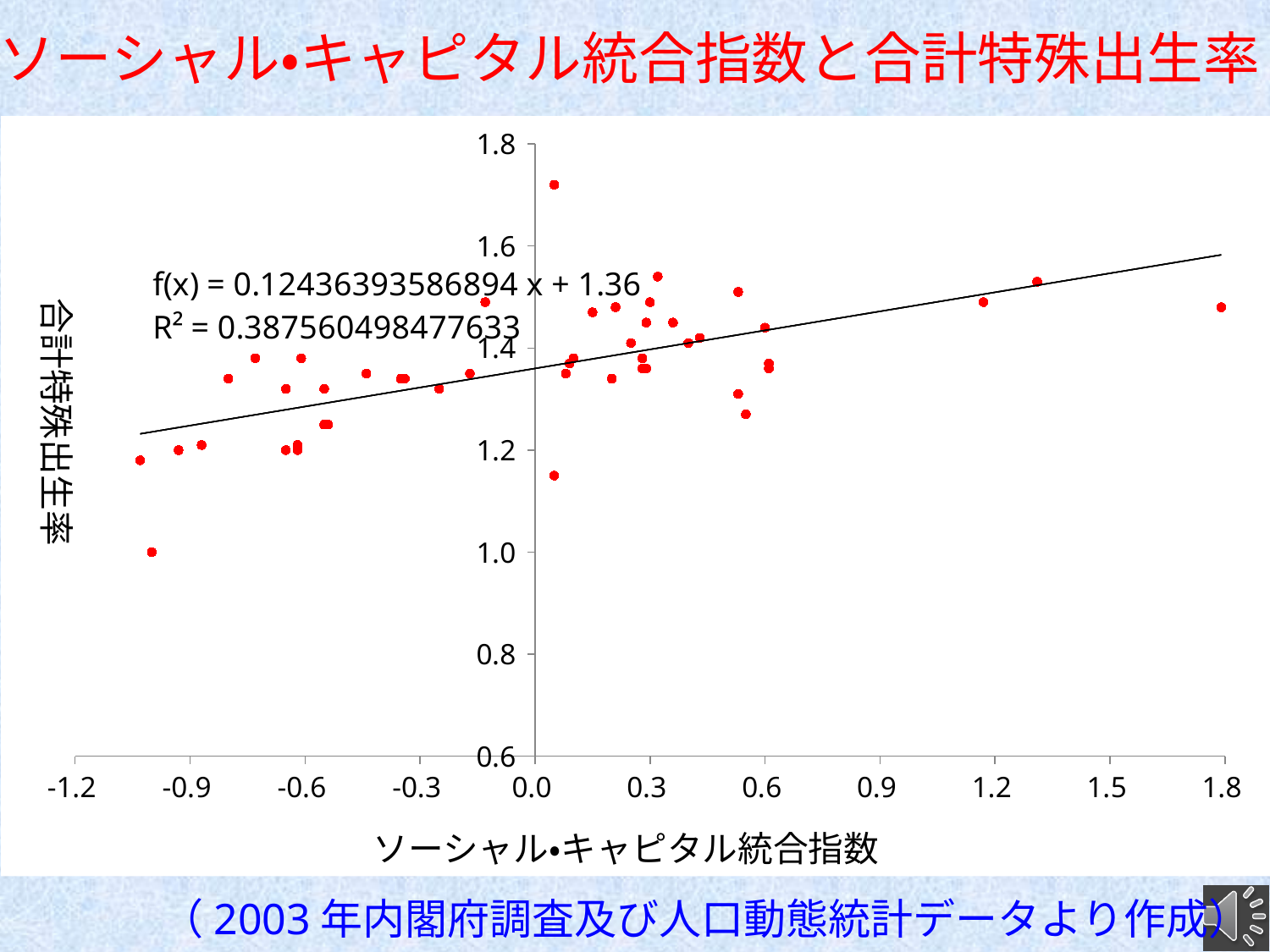
Is the y value of the lowest point on the chart greater or less than 1.2? less What R² value is printed on the chart? 0.387560498477633 What is the largest value shown on the x axis? 1.8 What kind of chart is shown on the slide? scatter plot Does the fitted trend line rise or fall as the x value increases? rises Is the y value of the highest point on the chart greater or less than 1.6? greater What is the smallest value shown on the y axis? 0.6 What is the label of the x axis? ソーシャル•キャピタル統合指数 What is the title of the chart on the slide? ソーシャル•キャピタル統合指数と合計特殊出生率 Is the y value of the rightmost point (near x = 1.8) greater or less than 1.4? greater What is the slope of the fitted line shown in the equation on the chart? 0.12436393586894 What is the intercept of the fitted line shown in the equation on the chart? 1.36